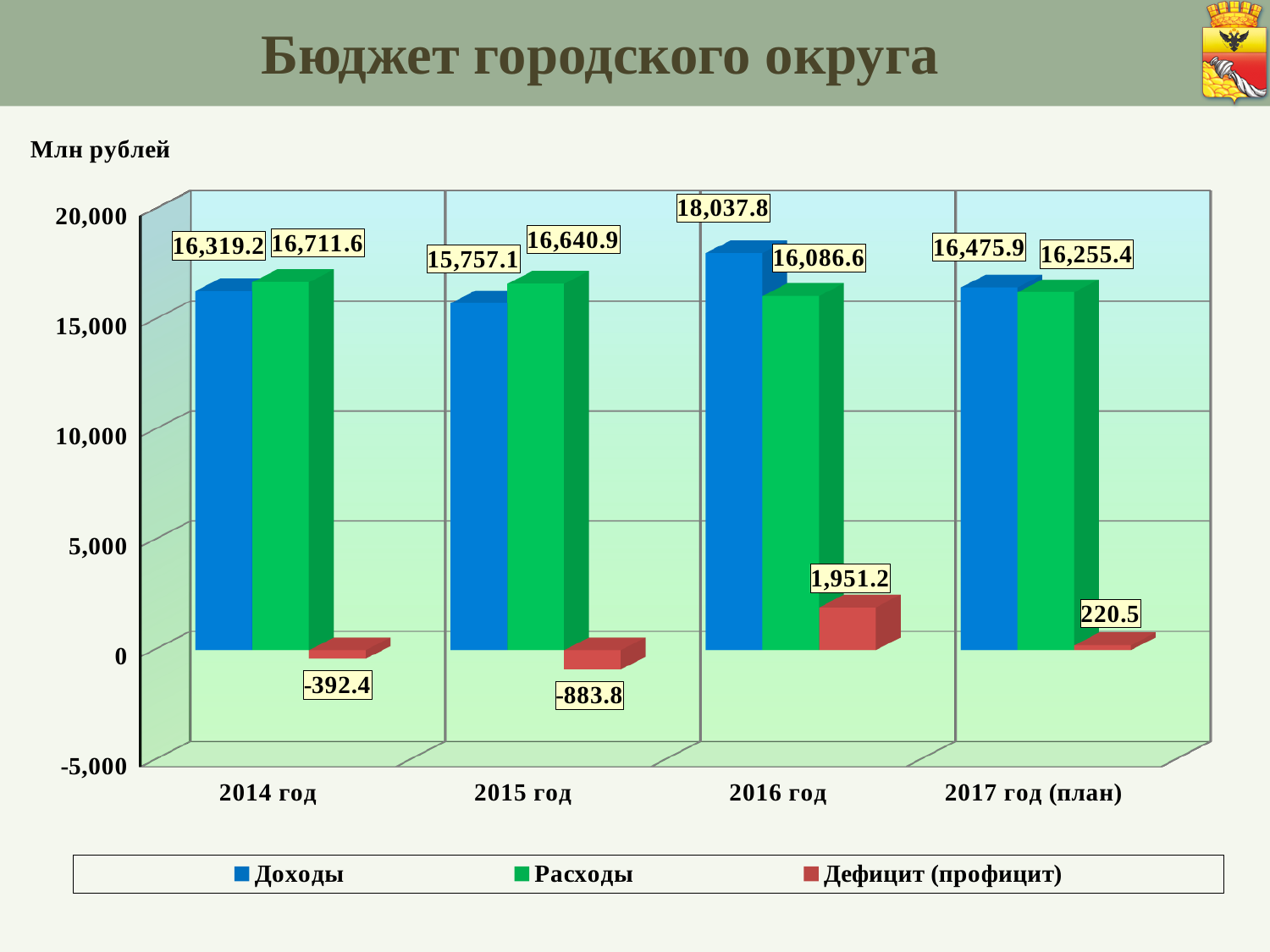
What is the value of Расходы for 2015 год? 16,640.9 In 2014 год, which is larger: Доходы or Расходы? Расходы What is the value of Дефицит (профицит) for 2015 год? -883.8 How many series does the legend list? 3 What unit is stated above the chart? Млн рублей What is the difference between Доходы and Расходы in 2016 год? 1,951.2 How many years (categories) are shown on the x axis? 4 What is the value of Доходы for 2014 год? 16,319.2 In which year are Доходы the highest? 2016 год What is the value of Дефицит (профицит) for 2016 год? 1,951.2 By how much do Доходы in 2016 год exceed Доходы in 2015 год? 2,280.7 In which year are Расходы the lowest? 2016 год